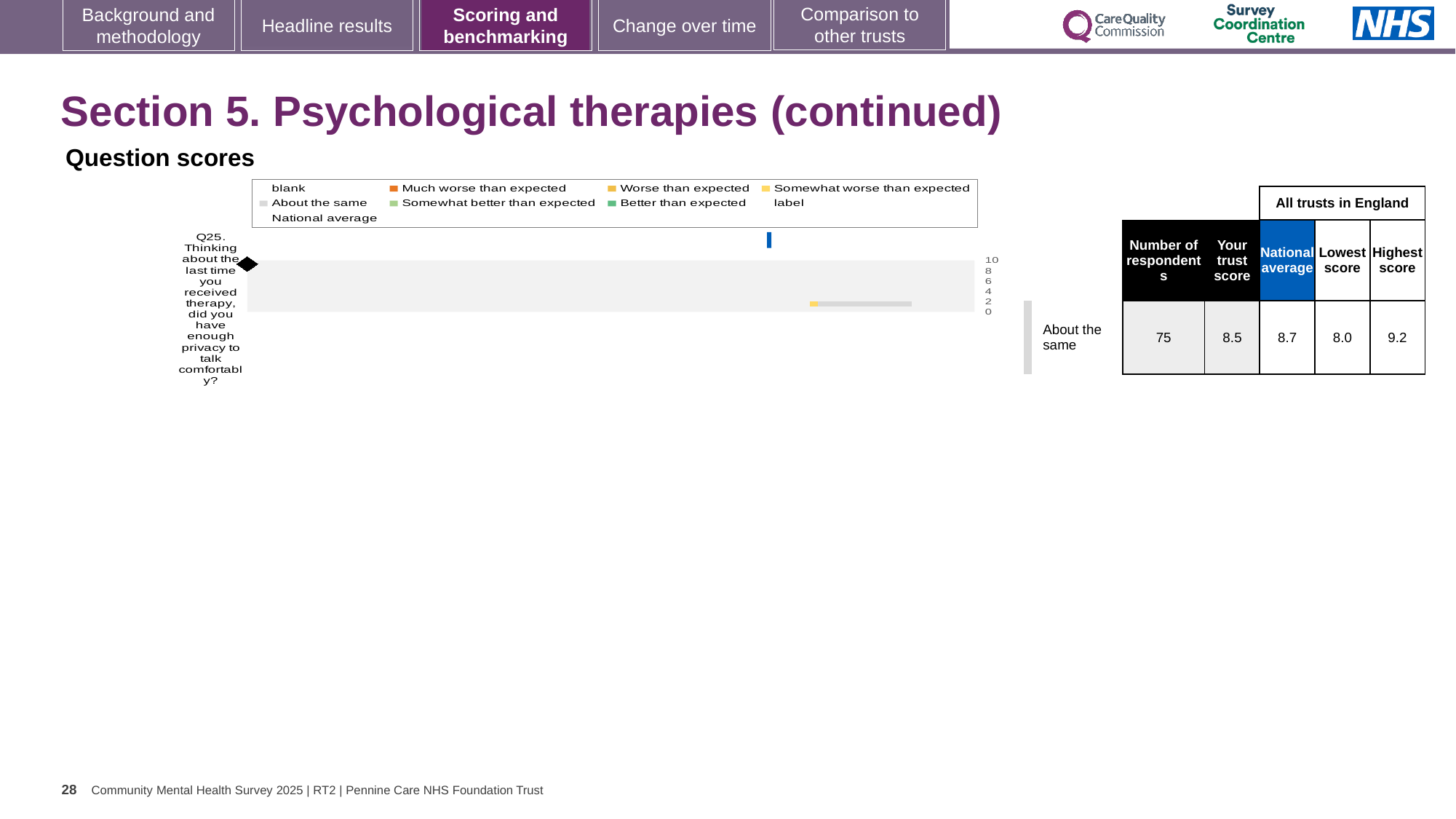
What is the National average score for Q25? 8.7 How many survey questions are plotted in the Question scores chart? 1 What is the Lowest score among all trusts in England for Q25? 8.0 For Q25, which is larger: the trust score or the National average? National average What kind of chart is shown under 'Question scores'? bar chart What is the Highest score among all trusts in England for Q25? 9.2 In the chart legend, which entry is marked with an orange square? Much worse than expected What benchmark rating is shown for Q25 next to the chart? About the same Which question number is plotted in the Question scores chart? Q25 How many respondents answered Q25? 75 What is the 'Your trust score' value for Q25? 8.5 For Q25, what is the difference between the Highest score and the Lowest score? 1.2